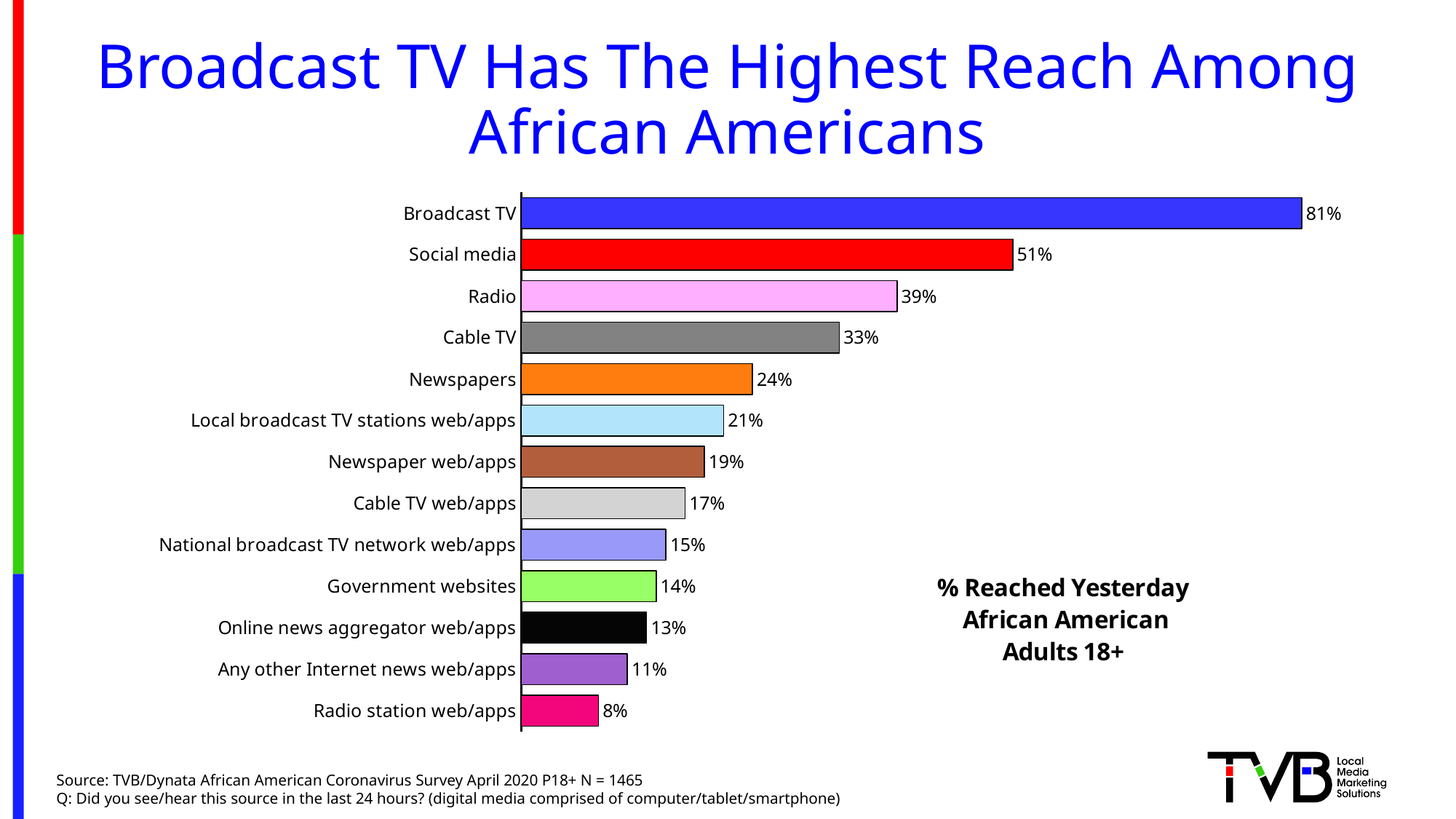
Which category has the lowest value? Radio station web/apps What is the difference between the values for Radio and Cable TV? 6% What colour is the bar for Social media? Red Which is larger, the value for Newspapers or the value for Newspaper web/apps? Newspapers What is the value for Social media? 51% What is the difference between the values for Broadcast TV and Social media? 30% Which category has the highest value? Broadcast TV How many categories are shown in the chart? 13 What is the value for Broadcast TV? 81% What kind of chart is shown on the slide? Bar chart What is the value for Government websites? 14% What is the value for Cable TV? 33%